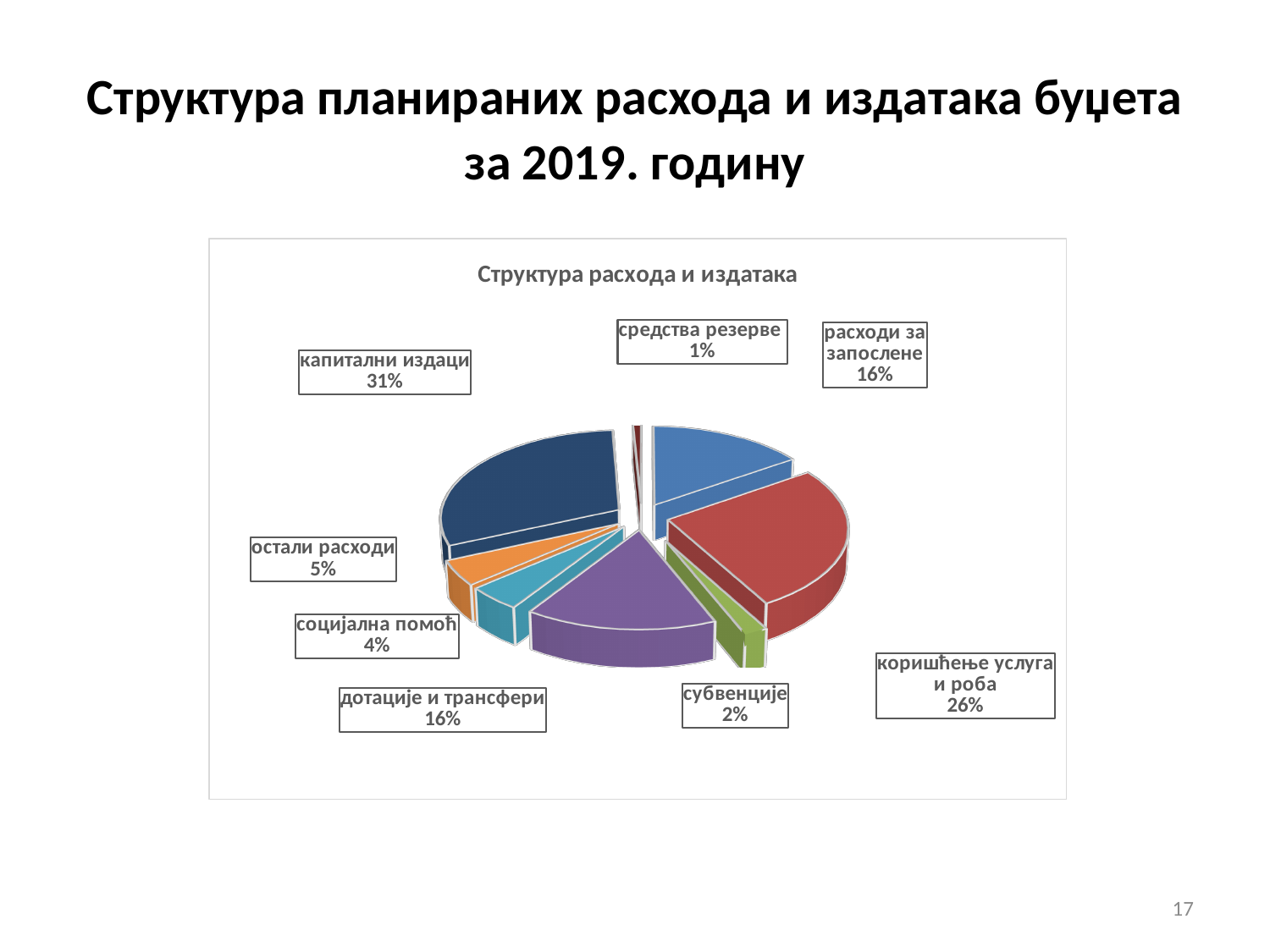
What kind of chart is shown on the slide? pie chart What share of the pie is капитални издаци? 31% What is the value shown for расходи за запослене? 16% What is the value shown for средства резерве? 1% What is the difference between the shares of капитални издаци and коришћење услуга и роба? 5% Which is larger, остали расходи or социјална помоћ? остали расходи Which category has the smallest share of the pie? средства резерве What is the value shown for субвенције? 2% What share of the pie is коришћење услуга и роба? 26% What is the chart's title? Структура расхода и издатака Which category has the largest share of the pie? капитални издаци How many categories does the pie chart show? 8